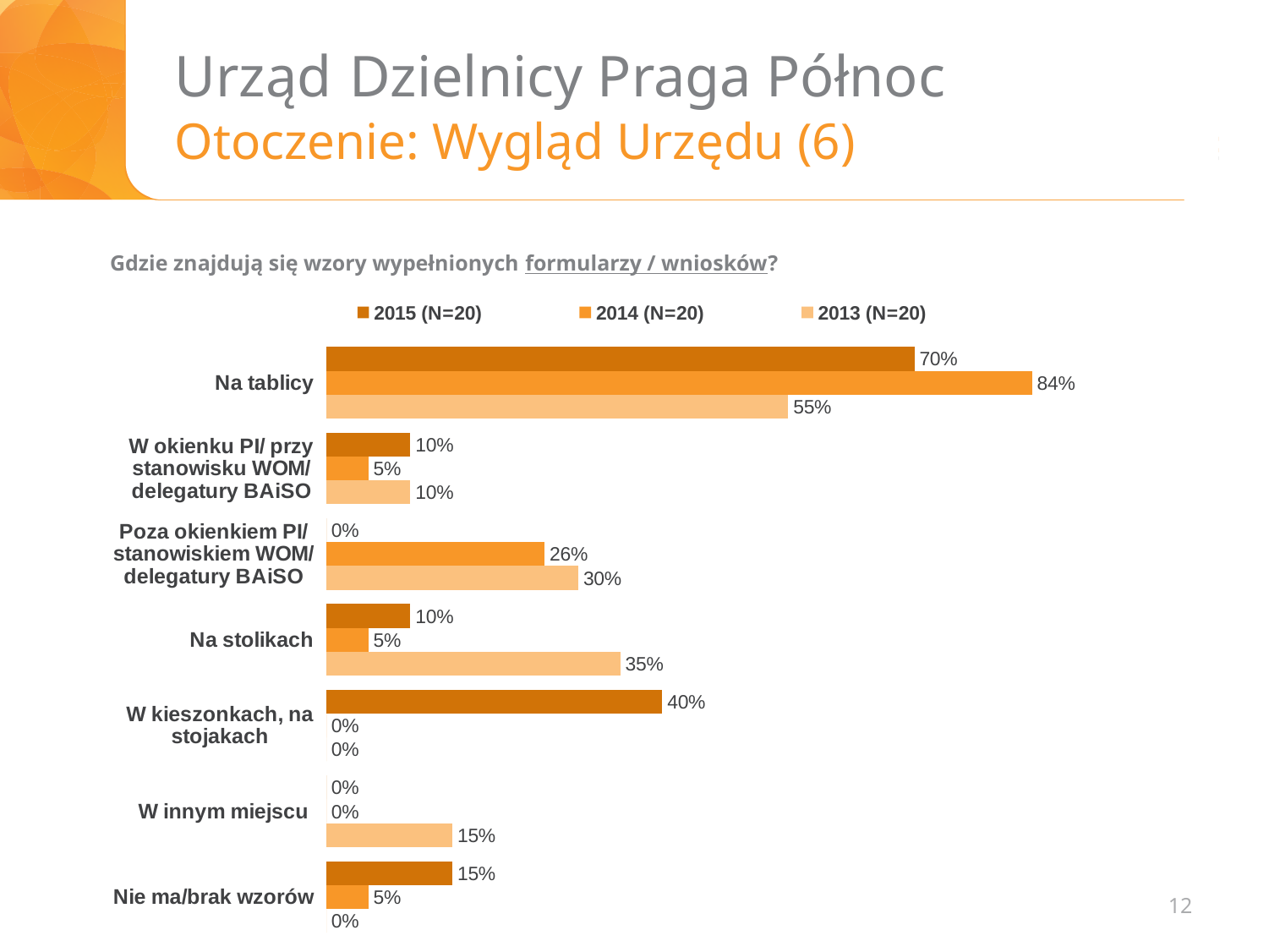
How many categories are shown on the chart? 7 What kind of chart is shown on the slide? Bar chart What is the value for "Na stolikach" in the 2013 (N=20) series? 35% What question is the chart answering, according to the text above it? Gdzie znajdują się wzory wypełnionych formularzy / wniosków? What is the value for "Na tablicy" in the 2014 (N=20) series? 84% How many series does the legend list? 3 What is the value for "Nie ma/brak wzorów" in the 2014 (N=20) series? 5% Which category has the highest value in the 2015 (N=20) series? Na tablicy What is the difference between the 2015 and 2014 values for "Nie ma/brak wzorów"? 10% What is the value for "W kieszonkach, na stojakach" in the 2015 (N=20) series? 40% What is the difference between the 2014 and 2013 values for "Na tablicy"? 29% Which is larger for "Poza okienkiem PI/ stanowiskiem WOM/ delegatury BAiSO": the 2014 value or the 2013 value? 2013